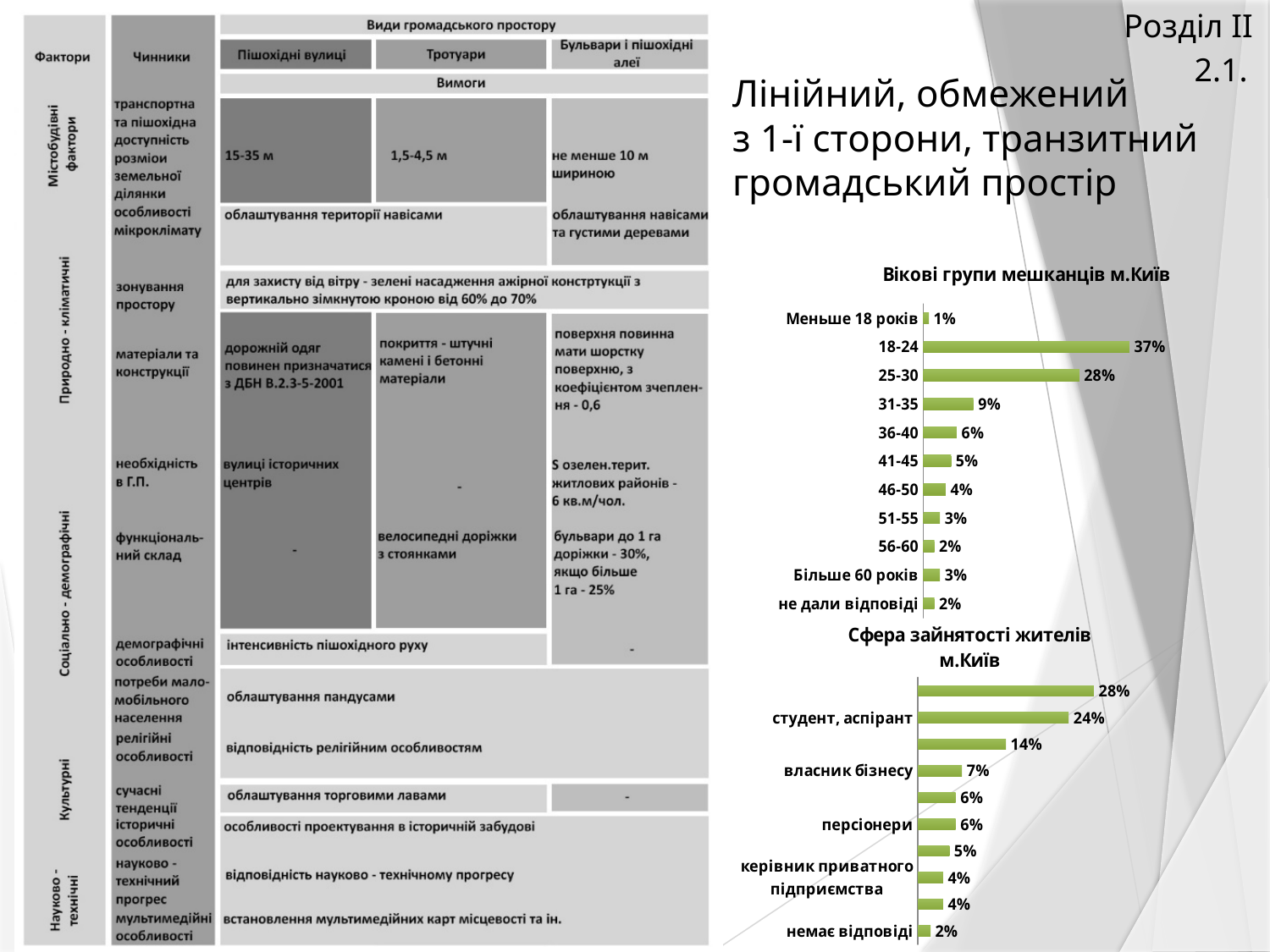
In the chart 'Вікові групи мешканців м.Київ', what is the value for the 25-30 age group? 28% In the chart 'Сфера зайнятості жителів м.Київ', what is the value for 'власник бізнесу'? 7% In the chart 'Сфера зайнятості жителів м.Київ', what is the value for 'студент, аспірант'? 24% In the chart 'Сфера зайнятості жителів м.Київ', what is the difference between 'студент, аспірант' and 'керівник приватного підприємства'? 20% In the chart 'Вікові групи мешканців м.Київ', which age group has the highest value? 18-24 In the chart 'Вікові групи мешканців м.Київ', what is the value for the 18-24 age group? 37% In the chart 'Вікові групи мешканців м.Київ', what is the value for 'Більше 60 років'? 3% How many categories are shown in the chart 'Вікові групи мешканців м.Київ'? 11 In the chart 'Вікові групи мешканців м.Київ', which is larger: the value for 31-35 or for 36-40? 31-35 What type of chart is 'Вікові групи мешканців м.Київ'? Bar chart In the chart 'Вікові групи мешканців м.Київ', which category has the lowest value? Меньше 18 років In the chart 'Вікові групи мешканців м.Київ', what is the difference between the 18-24 and 25-30 groups? 9%